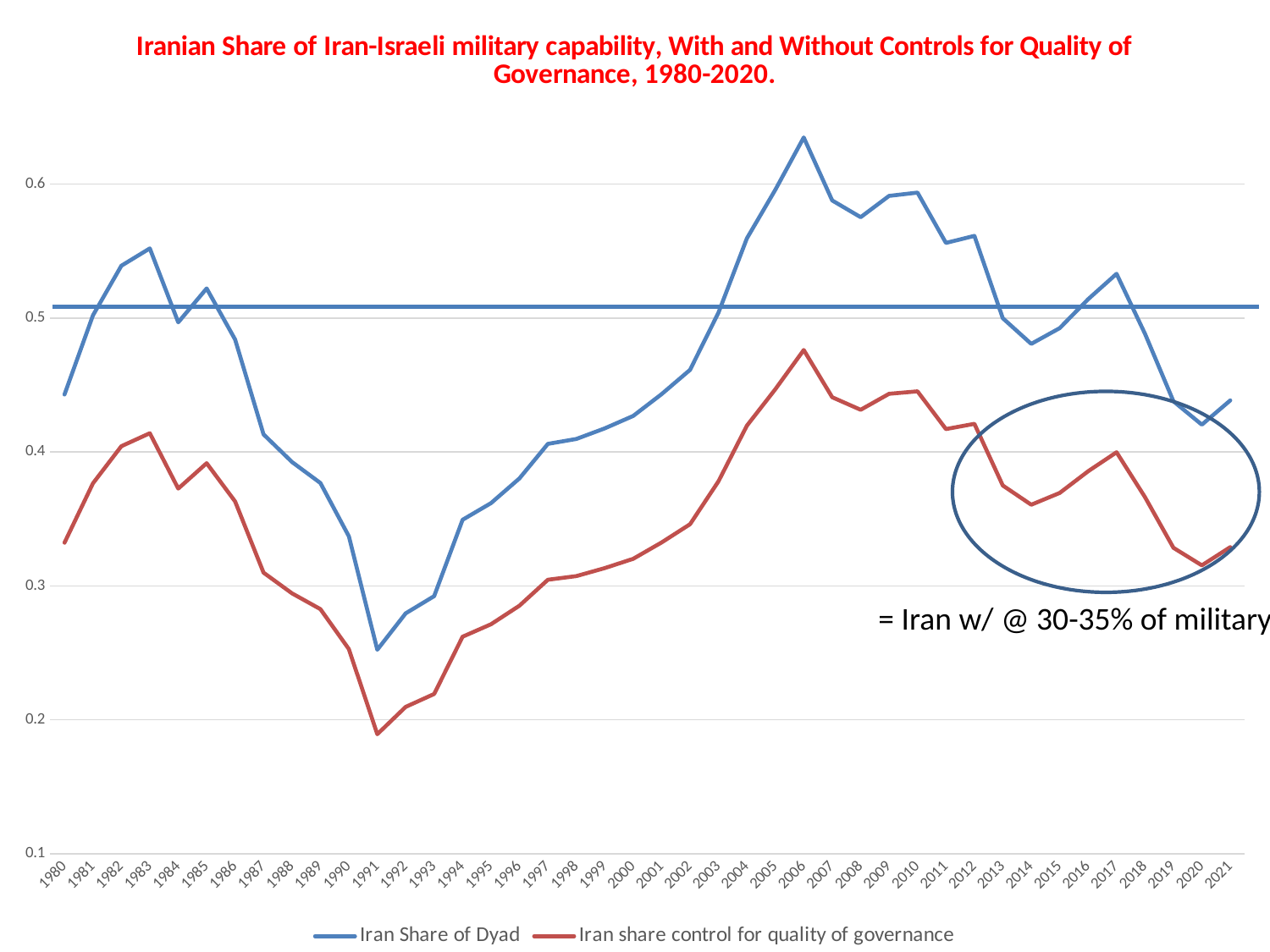
Is the Iran Share of Dyad value for 2006 greater or less than 0.6? greater In which year does the Iran share control for quality of governance series reach its lowest value? 1991 In 2006, which series has the higher value: Iran Share of Dyad or Iran share control for quality of governance? Iran Share of Dyad Does the Iran Share of Dyad series rise or fall between 2006 and 2020? fall Is the Iran share control for quality of governance value for 2006 greater or less than 0.5? less How many series does the legend list? 2 What kind of chart is shown on the slide? line chart Is the Iran share control for quality of governance value for 2020 greater or less than 0.4? less Which colour is used for the Iran share control for quality of governance series? red In which year does the Iran Share of Dyad series reach its highest value? 2006 How many years are plotted along the x axis? 42